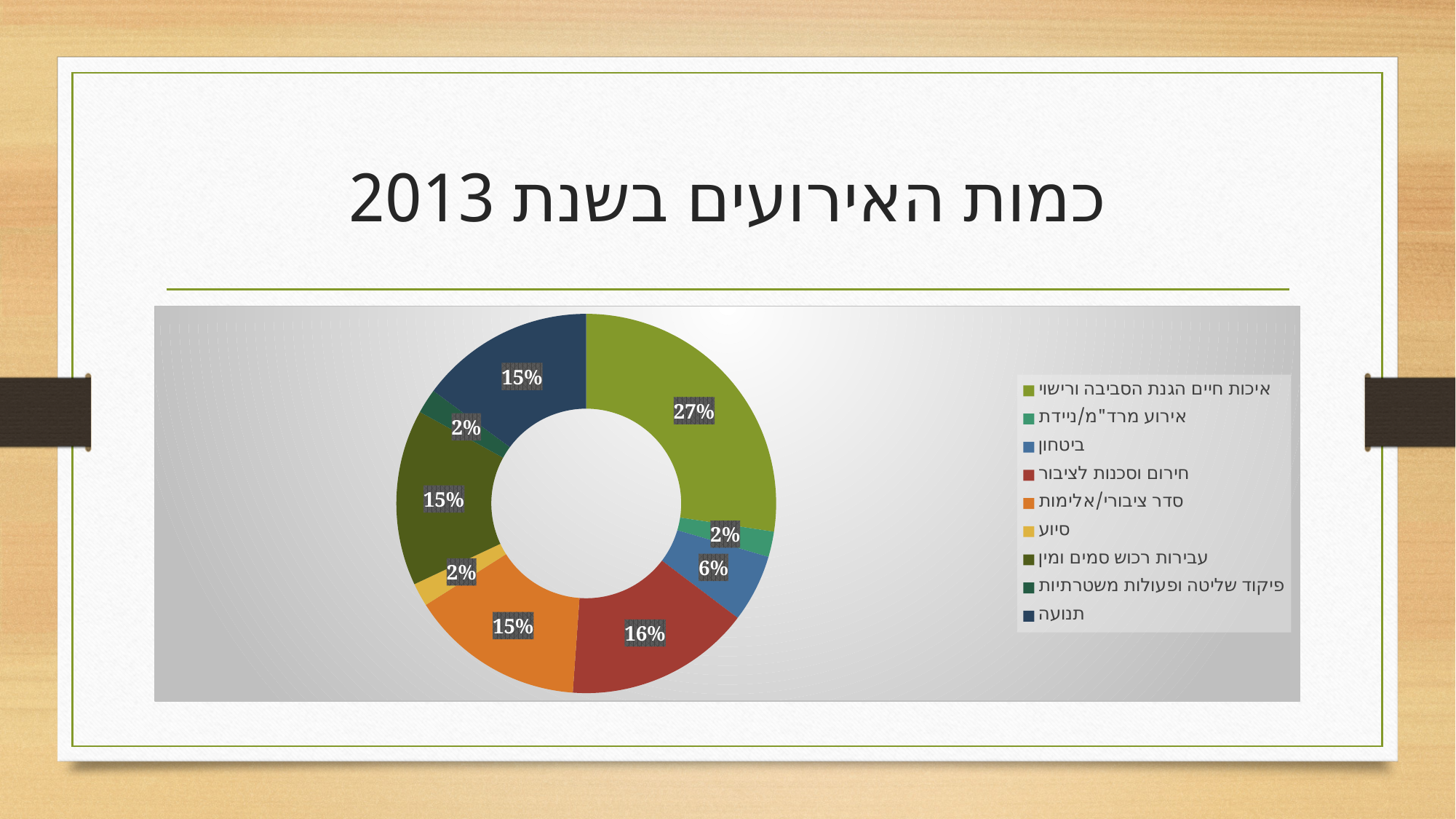
What colour is the slice for סדר ציבורי/אלימות? orange What share of the chart is סיוע? 2% Which category has the largest share of the chart? איכות חיים הגנת הסביבה ורישוי Which is larger: the share for ביטחון or the share for חירום וסכנות לציבור? חירום וסכנות לציבור What share of the chart is תנועה? 15% What share of the chart is חירום וסכנות לציבור? 16% What kind of chart is shown on the slide? doughnut chart How many categories does the chart show? 9 What is the difference in percentage points between the share for איכות חיים הגנת הסביבה ורישוי and the share for חירום וסכנות לציבור? 11 What share of the chart is ביטחון? 6% What is the title of the chart? כמות האירועים בשנת 2013 What share of the chart is איכות חיים הגנת הסביבה ורישוי? 27%